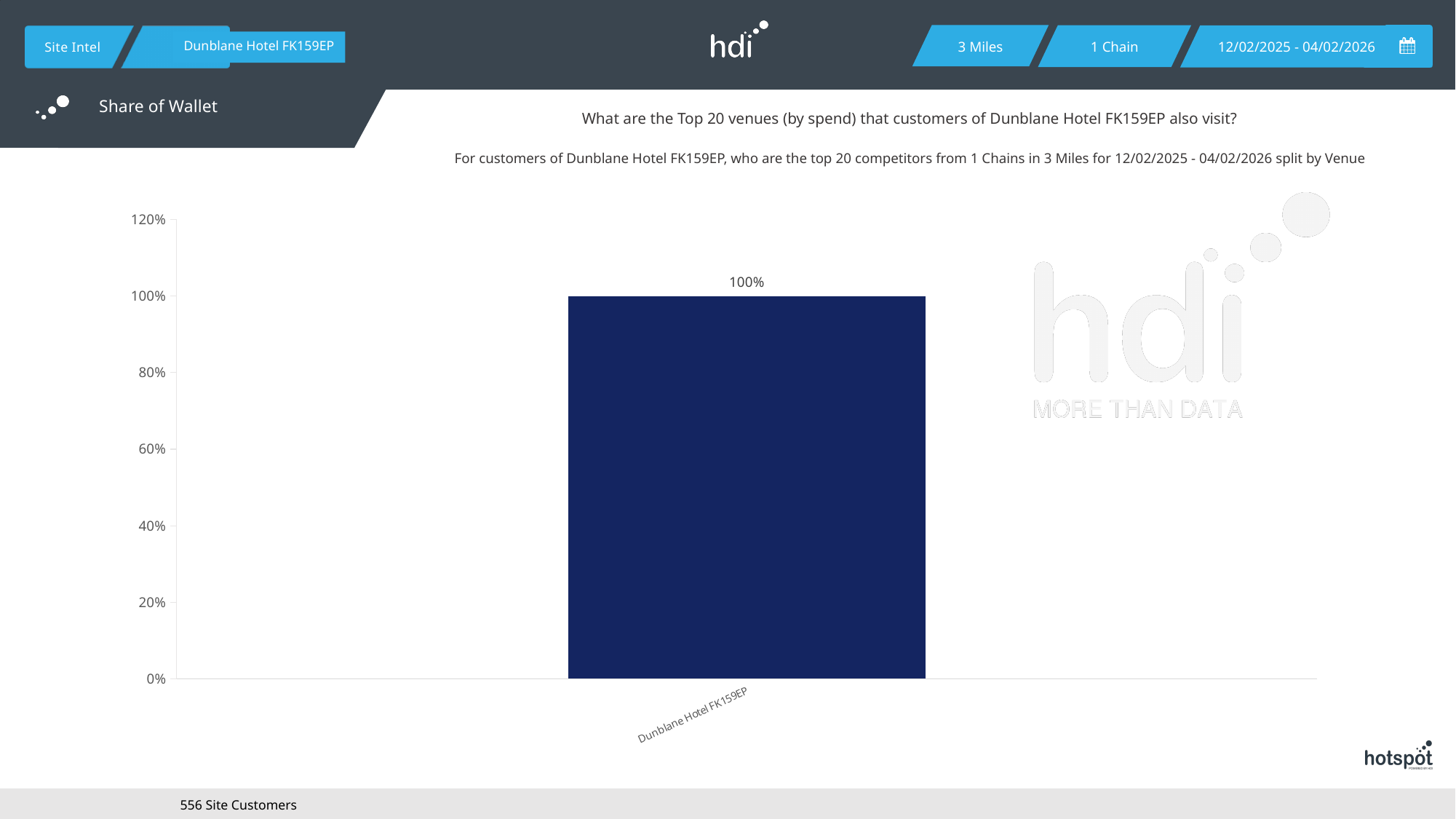
Is the value for Dunblane Hotel FK159EP greater or less than 120%? less What is the highest tick shown on the y axis? 120% Which category has the highest value? Dunblane Hotel FK159EP How many categories are plotted on the x axis? 1 What is the value for Dunblane Hotel FK159EP? 100% What is the label of the only category on the x axis? Dunblane Hotel FK159EP Is the value for Dunblane Hotel FK159EP greater or less than 80%? greater What kind of chart is shown on the slide? bar chart